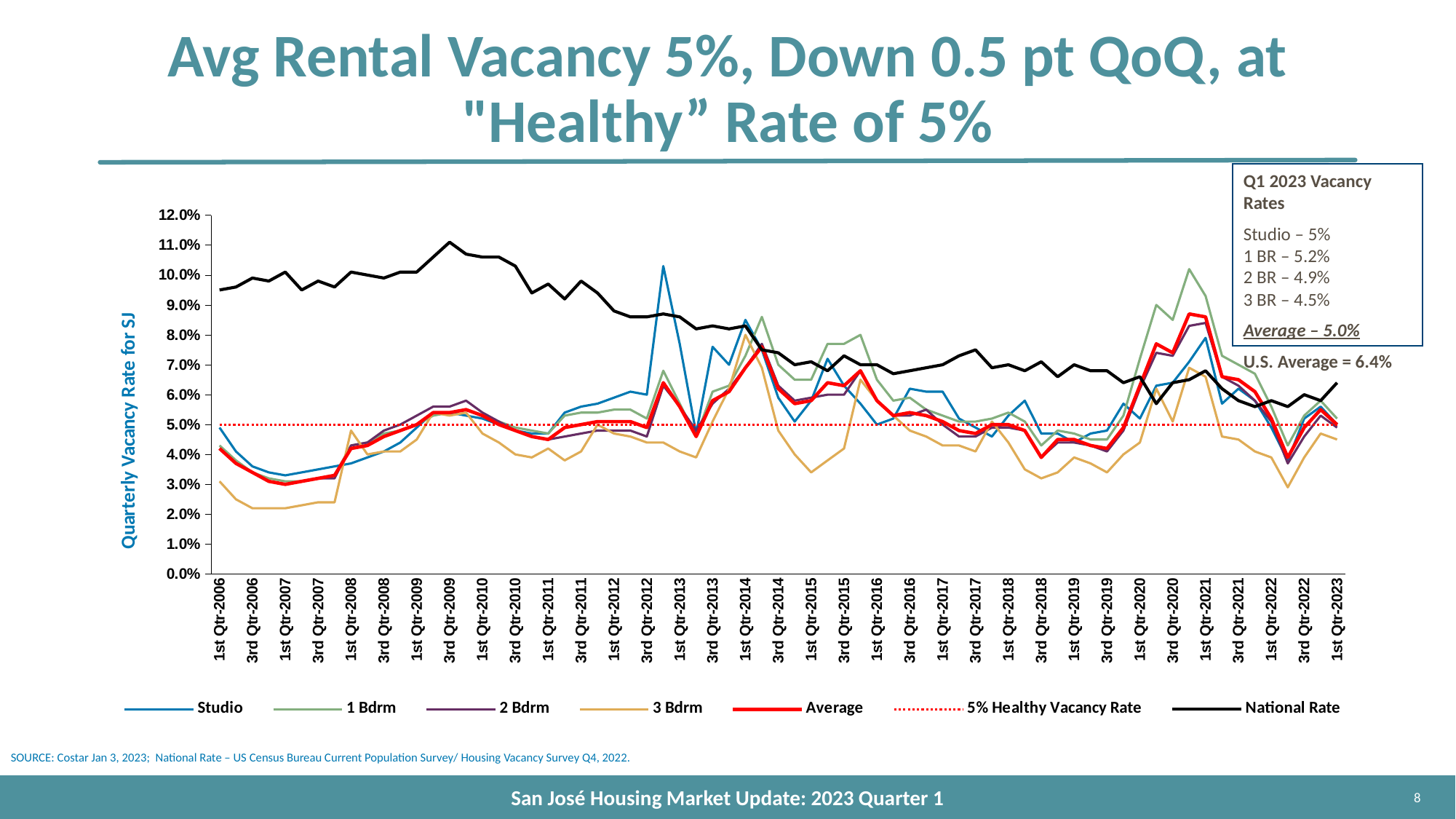
Is the 3 Bdrm value at 3rd Qtr-2006 greater or less than 3.0%? less Is the National Rate at 1st Qtr-2006 greater or less than 9.0%? greater Among the unit types listed in the Q1 2023 Vacancy Rates box, which has the lowest vacancy rate? 3 BR By how many percentage points does the Q1 2023 1 BR vacancy rate exceed the 3 BR rate? 0.7 What is the U.S. Average vacancy rate stated on the slide? 6.4% What kind of chart is shown on the slide? line chart How many series does the chart legend list? 7 According to the Q1 2023 Vacancy Rates box, what is the vacancy rate for 3 BR units? 4.5% What vacancy rate does the dotted red horizontal line represent? 5% Healthy Vacancy Rate According to the Q1 2023 Vacancy Rates box, what is the vacancy rate for 1 BR units? 5.2% In Q1 2023, which is higher: the 1 BR vacancy rate or the 2 BR vacancy rate? 1 BR Among the unit types listed in the Q1 2023 Vacancy Rates box, which has the highest vacancy rate? 1 BR